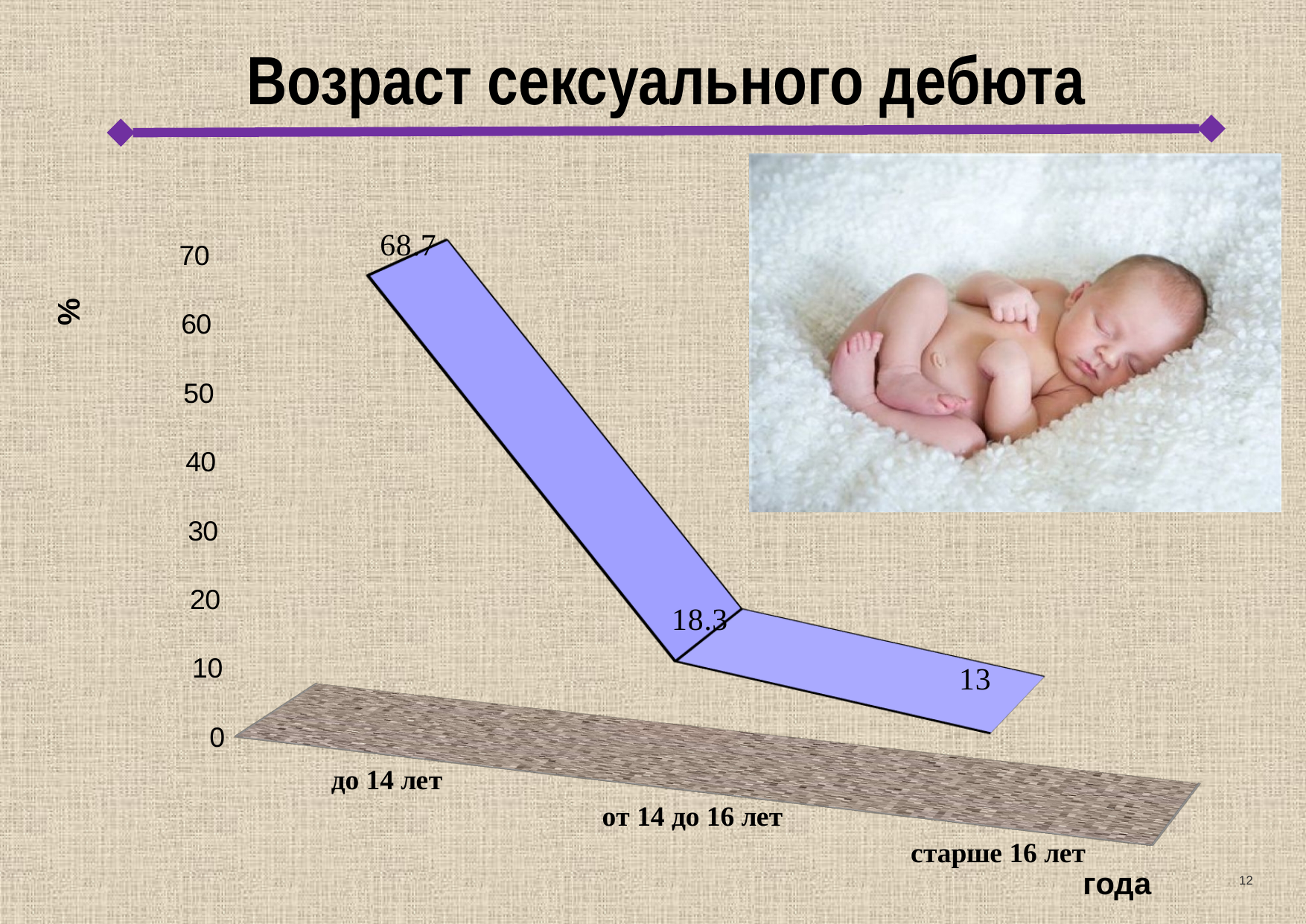
Which category has the highest value? до 14 лет Is the value for "до 14 лет" greater or less than 60? greater What is the value for the category "до 14 лет"? 68.7 Do the values rise or fall from left to right along the x axis? fall What is the value for the category "от 14 до 16 лет"? 18.3 What is the value for the category "старше 16 лет"? 13 What is the difference between the values for "до 14 лет" and "от 14 до 16 лет"? 50.4 What is the difference between the values for "от 14 до 16 лет" and "старше 16 лет"? 5.3 How many categories are shown on the x axis? 3 What kind of chart is shown on the slide? line chart Which is larger: the value for "от 14 до 16 лет" or the value for "старше 16 лет"? от 14 до 16 лет Which category has the lowest value? старше 16 лет